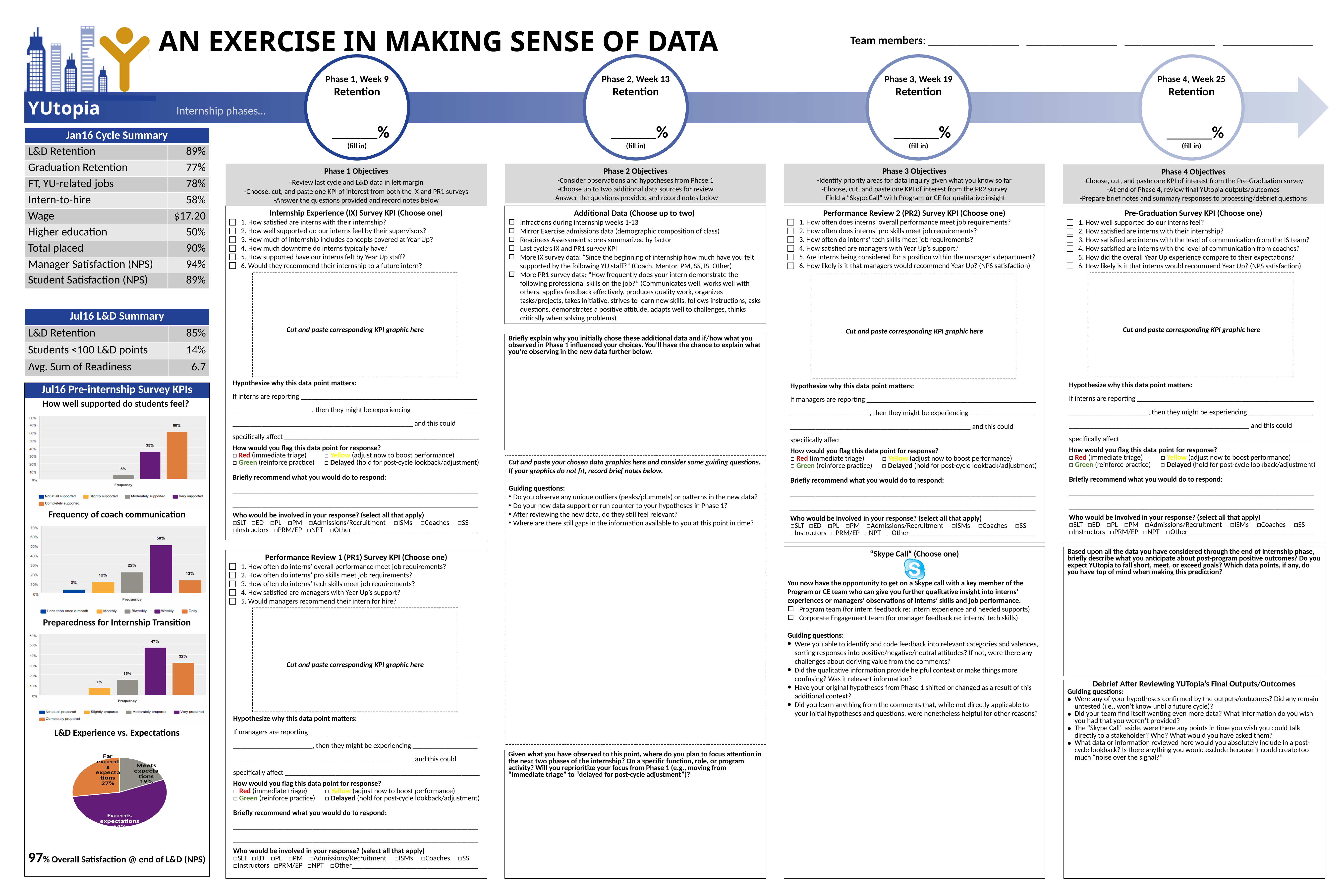
In the 'Frequency of coach communication' chart, which category has the lowest value? Less than once a month In the 'Frequency of coach communication' chart, how many categories does the legend list? 5 In the 'L&D Experience vs. Expectations' pie chart, what share is 'Meets expectations'? 19% In the 'Frequency of coach communication' chart, what is the value for Weekly? 50% In the 'How well supported do students feel?' chart, which category has the highest value? Completely supported In the 'L&D Experience vs. Expectations' pie chart, which slice is the largest? Exceeds expectations In the 'Preparedness for Internship Transition' chart, what is the value for Very prepared? 47% In the 'How well supported do students feel?' chart, what is the value for Completely supported? 60% In the 'Frequency of coach communication' chart, what is the difference between the Biweekly and Monthly values? 10% What kind of chart is 'L&D Experience vs. Expectations'? Pie chart In the 'Preparedness for Internship Transition' chart, which is larger, Completely prepared or Moderately prepared? Completely prepared In the 'Preparedness for Internship Transition' chart, what is the difference between Very prepared and Completely prepared? 15%